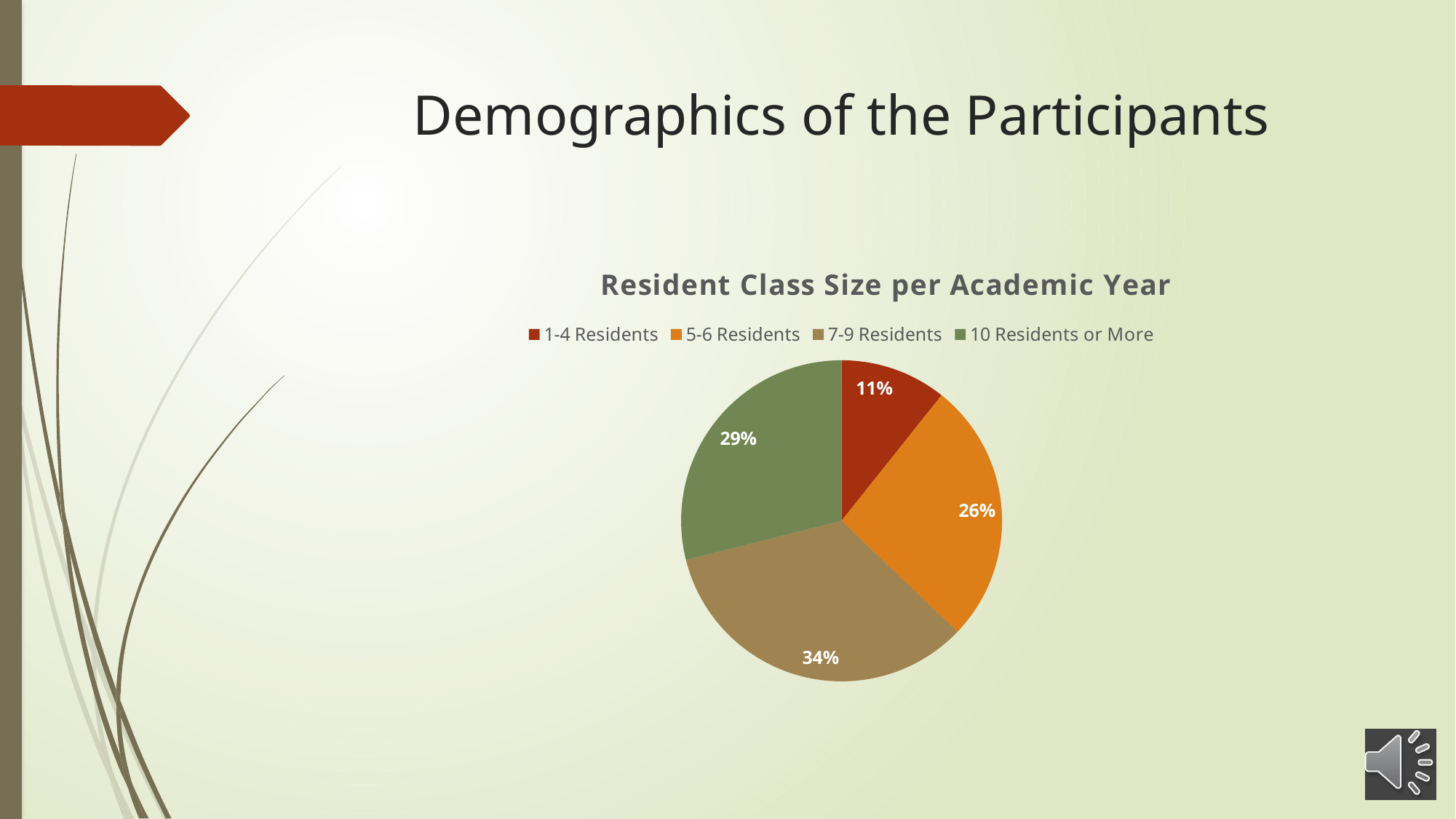
What share of the pie is 5-6 Residents? 26% What share of the pie is 10 Residents or More? 29% Which is larger, the share for 5-6 Residents or the share for 10 Residents or More? 10 Residents or More What is the difference in percentage points between 7-9 Residents and 1-4 Residents? 23 What share of the pie is 1-4 Residents? 11% How many categories does the pie chart show? 4 What is the title of the chart? Resident Class Size per Academic Year Which category has the smallest slice of the pie? 1-4 Residents What kind of chart is shown on the slide? pie chart What colour is the slice for 10 Residents or More? green Which category has the largest slice of the pie? 7-9 Residents